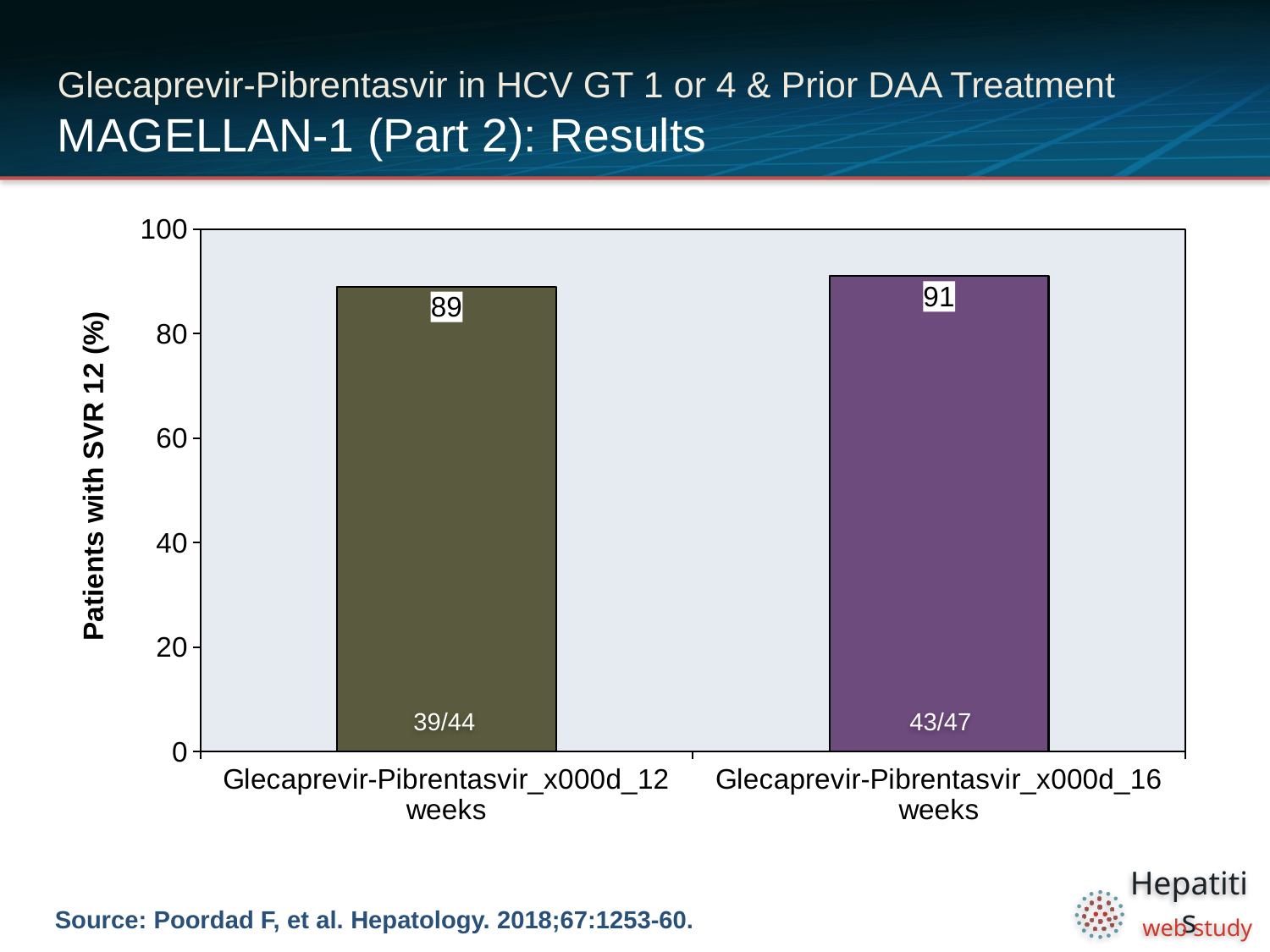
What is the SVR 12 rate for Glecaprevir-Pibrentasvir 16 weeks? 91 How many treatment arms are plotted in the chart? 2 Is the SVR 12 rate for Glecaprevir-Pibrentasvir 12 weeks greater or less than 80? greater What is the label of the y axis? Patients with SVR 12 (%) Is the SVR 12 rate for Glecaprevir-Pibrentasvir 16 weeks greater or less than 100? less Which treatment arm has the higher SVR 12 rate? Glecaprevir-Pibrentasvir 16 weeks What fraction of patients is shown inside the Glecaprevir-Pibrentasvir 16 weeks bar? 43/47 What is the SVR 12 rate for Glecaprevir-Pibrentasvir 12 weeks? 89 What fraction of patients is shown inside the Glecaprevir-Pibrentasvir 12 weeks bar? 39/44 What is the difference in SVR 12 rate between the 16-week and 12-week arms? 2 Which treatment arm has the lower SVR 12 rate? Glecaprevir-Pibrentasvir 12 weeks What kind of chart is shown on the slide? Bar chart